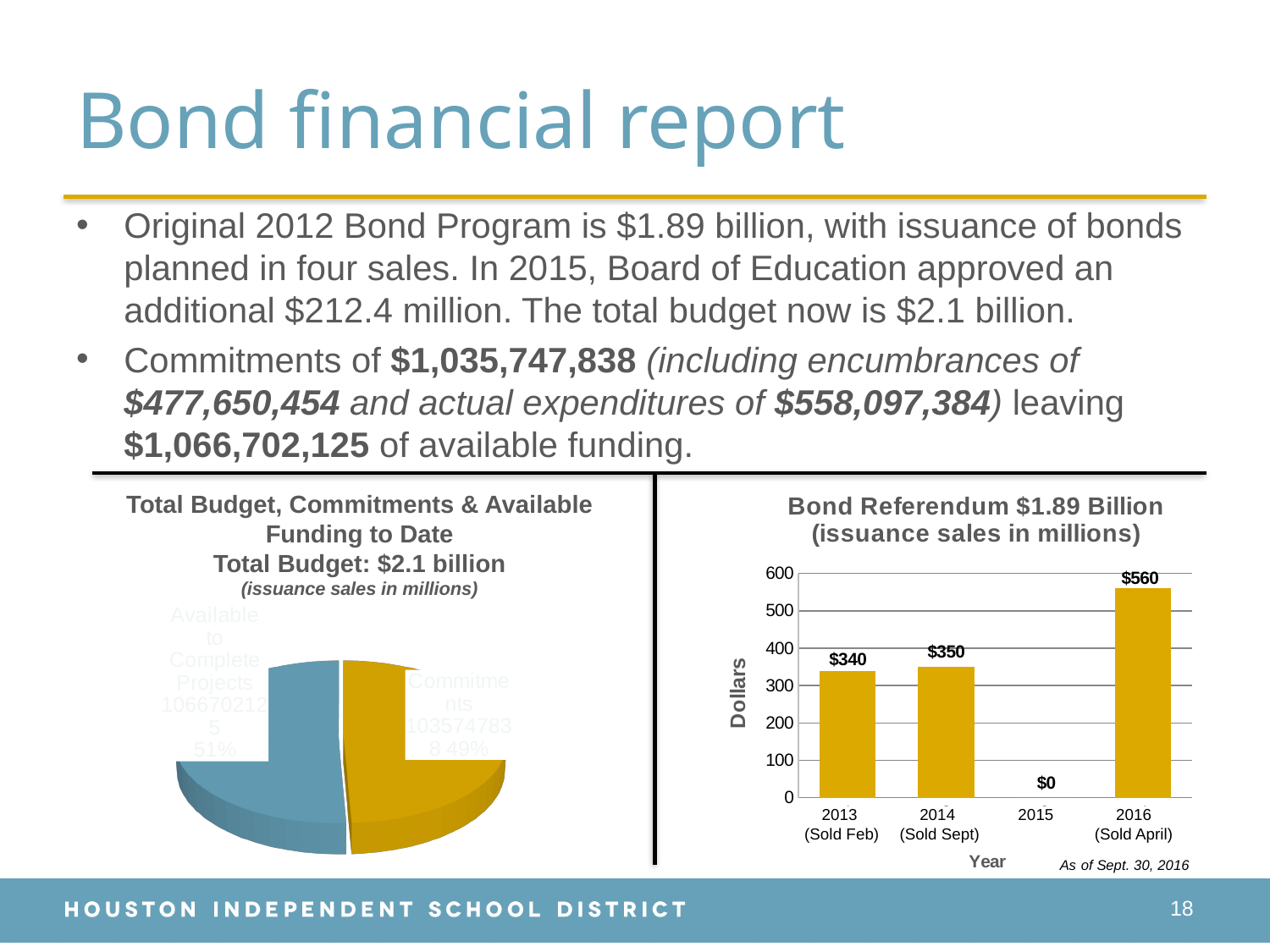
In the 'Bond Referendum $1.89 Billion' chart, how many years are shown on the x axis? 4 What kind of chart is the 'Total Budget, Commitments & Available Funding to Date' chart on the left? Pie chart In the 'Bond Referendum $1.89 Billion' chart, which year has the lowest issuance sales? 2015 What kind of chart is the 'Bond Referendum $1.89 Billion' chart? Bar chart In the 'Bond Referendum $1.89 Billion' chart, which year has the highest issuance sales? 2016 In the 'Bond Referendum $1.89 Billion' chart, which is larger, the value for 2014 or the value for 2013? 2014 In the 'Bond Referendum $1.89 Billion' chart, what is the value for 2014 (Sold Sept)? $350 In the 'Bond Referendum $1.89 Billion' chart, what is the value for 2016 (Sold April)? $560 In the 'Bond Referendum $1.89 Billion' chart, what is the value for 2015? $0 What is the y-axis label of the 'Bond Referendum $1.89 Billion' chart? Dollars In the 'Bond Referendum $1.89 Billion' chart, what is the difference between the 2016 and 2013 values? $220 In the 'Bond Referendum $1.89 Billion' chart, what is the value for 2013 (Sold Feb)? $340